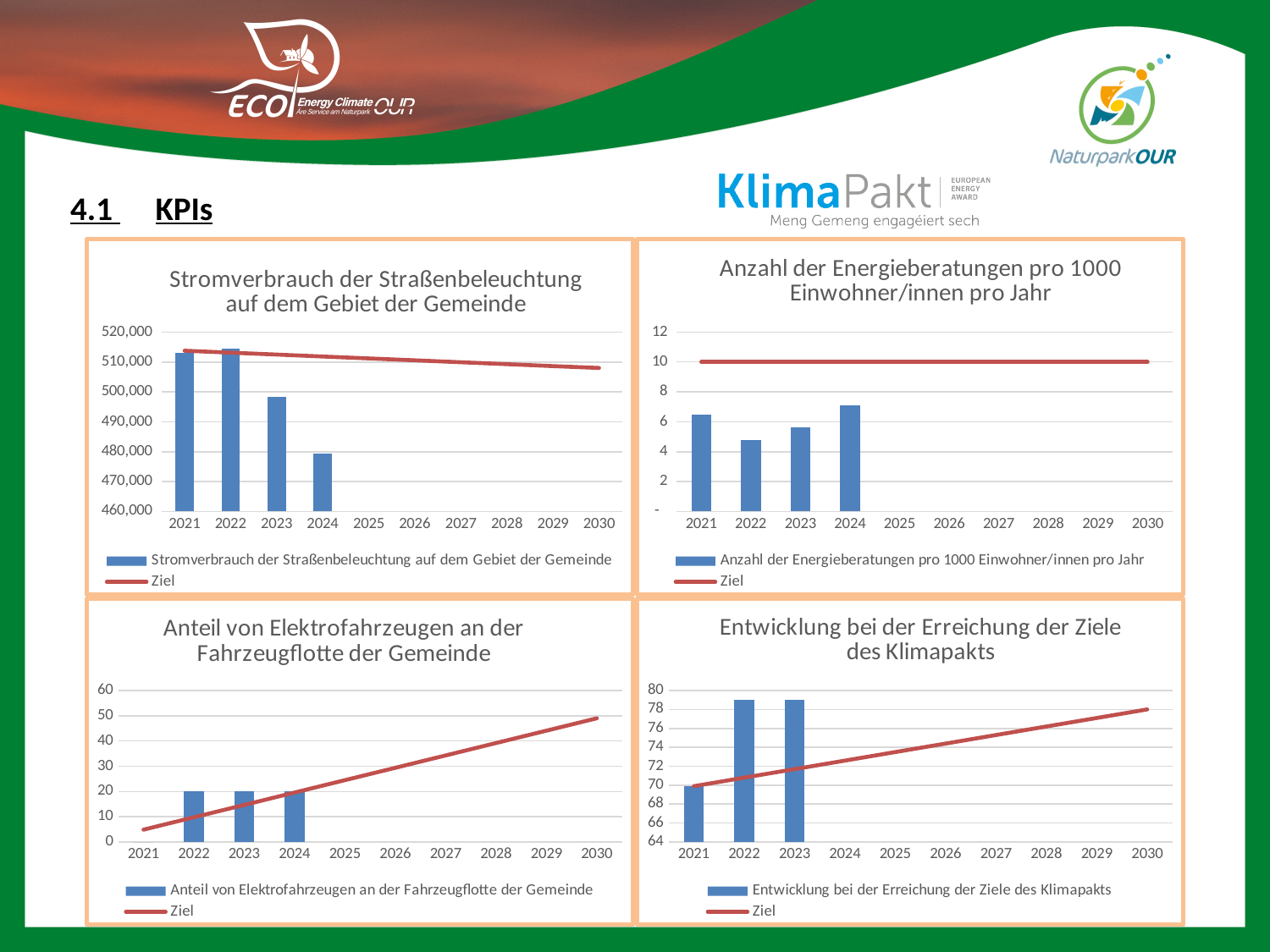
In the chart 'Anzahl der Energieberatungen pro 1000 Einwohner/innen pro Jahr', what value does the Ziel line sit at? 10 In the chart 'Anteil von Elektrofahrzeugen an der Fahrzeugflotte der Gemeinde', how many years have a bar plotted? 3 In the chart 'Entwicklung bei der Erreichung der Ziele des Klimapakts', is the value for 2022 greater or less than 76? greater How many series does the legend of the chart 'Entwicklung bei der Erreichung der Ziele des Klimapakts' list? 2 In the chart 'Stromverbrauch der Straßenbeleuchtung auf dem Gebiet der Gemeinde', do the bar values rise or fall from 2022 to 2024? fall In the chart 'Anzahl der Energieberatungen pro 1000 Einwohner/innen pro Jahr', which year has the lowest bar? 2022 In the chart 'Stromverbrauch der Straßenbeleuchtung auf dem Gebiet der Gemeinde', which year has the lowest bar? 2024 In the chart 'Anteil von Elektrofahrzeugen an der Fahrzeugflotte der Gemeinde', what is the value for 2023? 20 In the chart 'Entwicklung bei der Erreichung der Ziele des Klimapakts', which year has the lowest bar? 2021 In the chart 'Stromverbrauch der Straßenbeleuchtung auf dem Gebiet der Gemeinde', is the value for 2024 greater or less than 490,000? less In the chart 'Anzahl der Energieberatungen pro 1000 Einwohner/innen pro Jahr', is the value for 2022 greater or less than 6? less In the chart 'Anzahl der Energieberatungen pro 1000 Einwohner/innen pro Jahr', which year has the highest bar? 2024